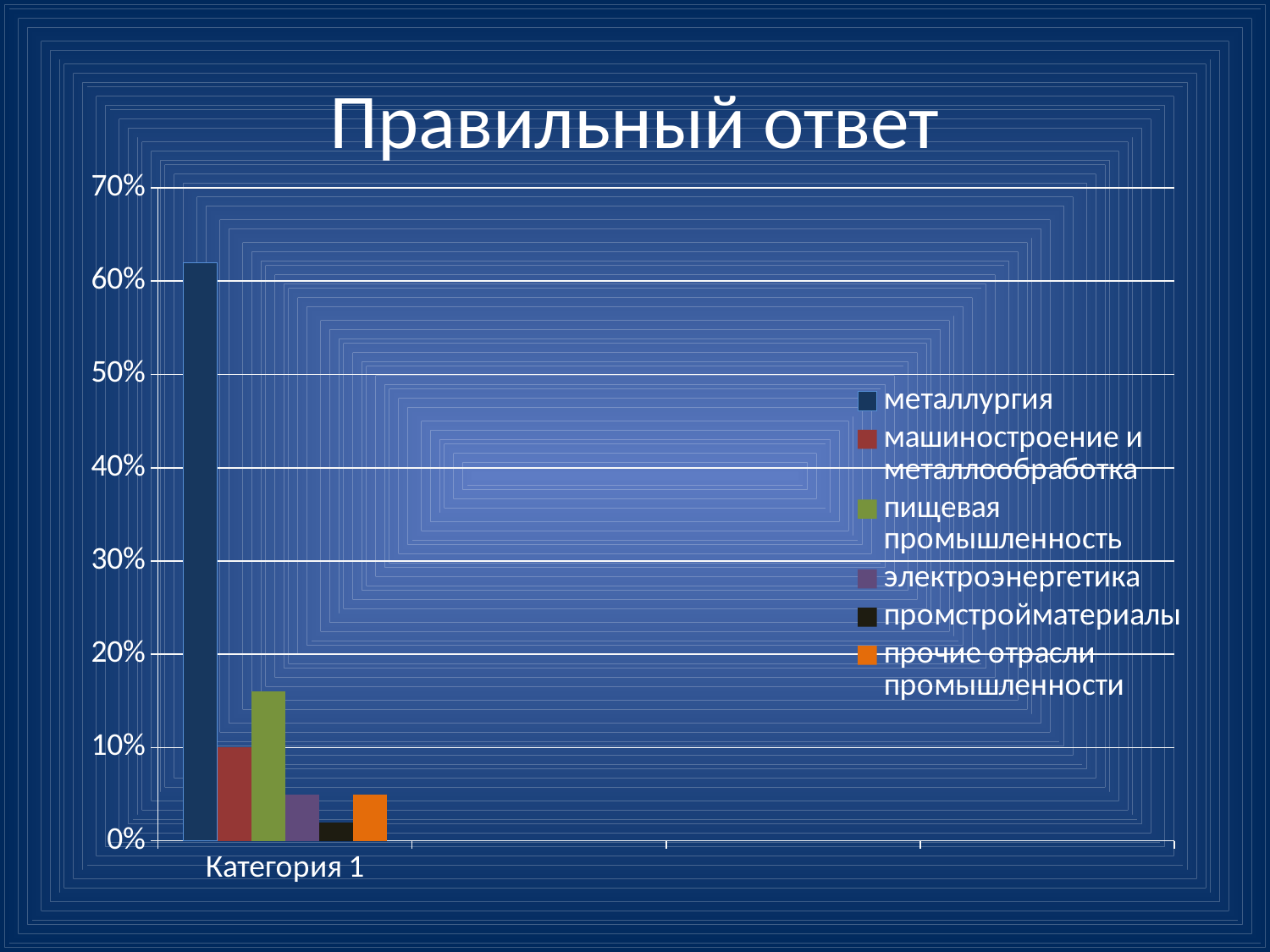
Is the value for пищевая промышленность greater or less than 20%? less Which is larger, the value for пищевая промышленность or the value for машиностроение и металлообработка? пищевая промышленность Which is larger, the value for металлургия or the value for электроэнергетика? металлургия How many series does the legend list? 6 Which series has the highest value? металлургия What is the label of the category on the x axis? Категория 1 Is the value for металлургия greater or less than 50%? greater Which series has the lowest value? промстройматериалы What kind of chart is shown on the slide? bar chart What is the title of the slide? Правильный ответ Is the value for электроэнергетика greater or less than 10%? less How many categories are shown on the x axis? 1